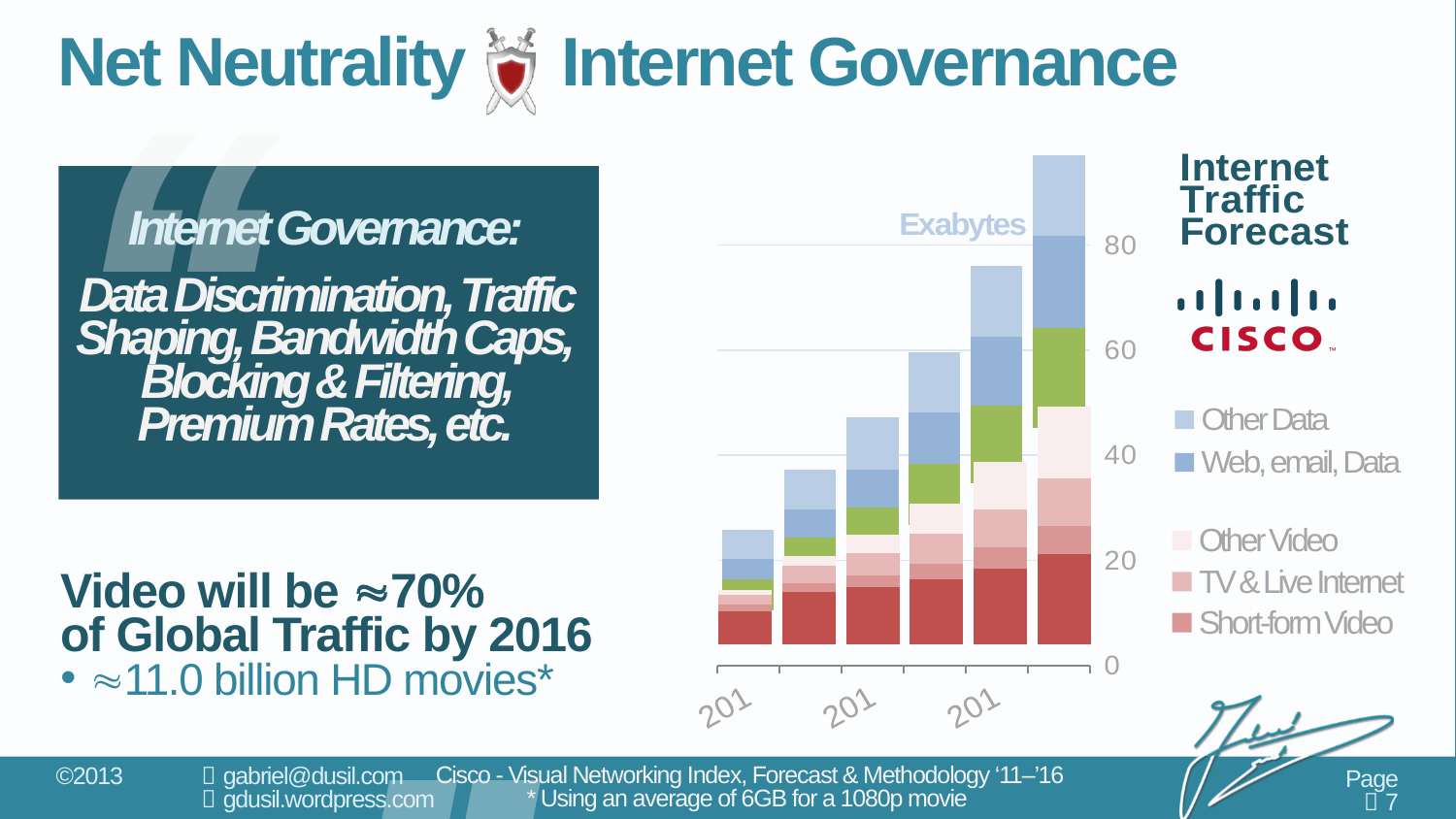
Which bar in the Internet Traffic Forecast chart has the smallest total height? the leftmost bar How many series does the legend of the Internet Traffic Forecast chart list? 5 How many bars are plotted in the Internet Traffic Forecast chart? 6 What kind of chart is shown on the slide? stacked bar chart What unit is shown as the label above the Internet Traffic Forecast chart? Exabytes Which bar in the Internet Traffic Forecast chart has the greatest total height? the rightmost bar Which legend entry in the Internet Traffic Forecast chart is shown in dark red at the bottom of the stacks? Short-form Video Is the total of the fifth bar from the left in the Internet Traffic Forecast chart greater or less than 60? greater Is the total of the rightmost bar in the Internet Traffic Forecast chart greater or less than 80? greater Do the total bar heights in the Internet Traffic Forecast chart rise or fall from left to right? rise Is the total of the leftmost bar in the Internet Traffic Forecast chart greater or less than 40? less